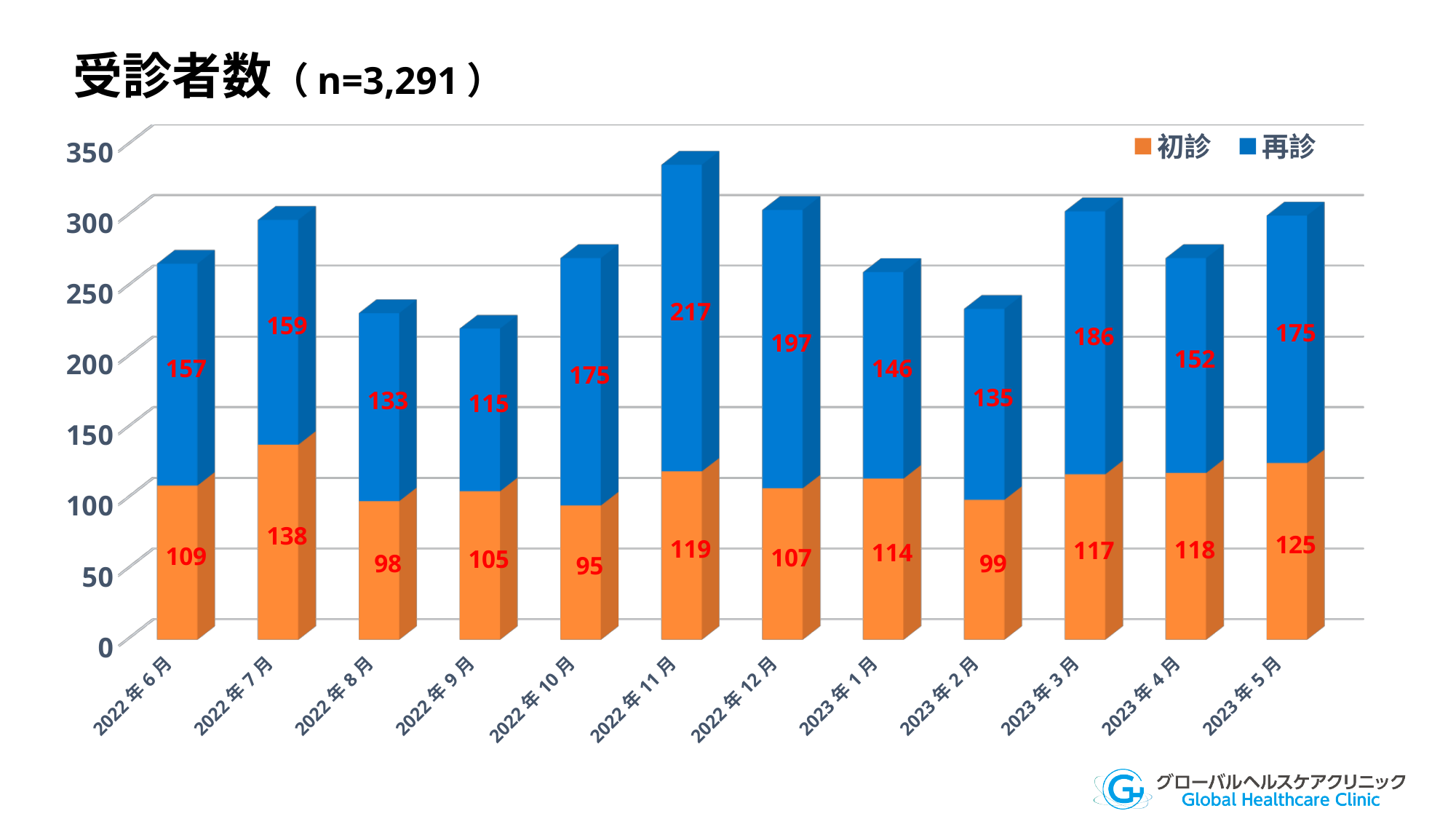
What is the total of the stacked bar for 2022年11月? 336 Which month has the highest 再診 value? 2022年11月 What is the 再診 value for 2023年2月? 135 Which month has the lowest 初診 value? 2022年10月 What is the 再診 value for 2022年11月? 217 What is the 初診 value for 2022年7月? 138 How many months are shown on the x axis? 12 What is the total of the stacked bar for 2022年9月? 220 Which is larger, the 初診 value for 2023年5月 or the 初診 value for 2022年7月? 2022年7月 What kind of chart is shown on the slide? Stacked bar chart What is the difference between the 再診 and 初診 values for 2022年12月? 90 How many series does the legend list? 2